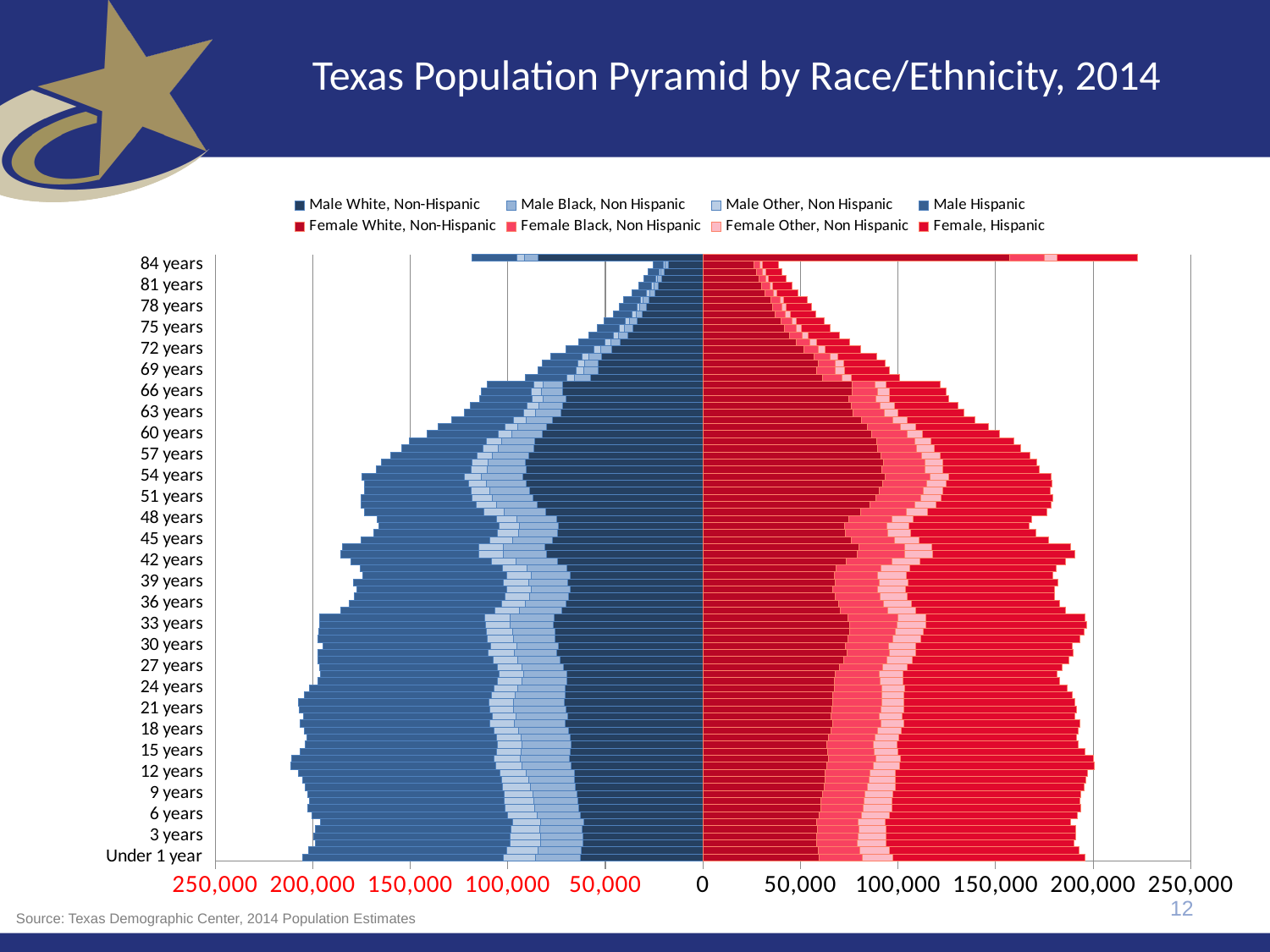
Is the total male value for 78 years greater or less than 50,000? less Do the total male bars rise or fall as age increases from 60 years to 81 years? fall What is the title of the chart? Texas Population Pyramid by Race/Ethnicity, 2014 Is the total male value for 84 years greater or less than 150,000? less What kind of chart is shown on the slide? bar chart How many series does the legend list? 8 On which side of the zero axis are the male series plotted? left Is the total female value for 54 years greater or less than 150,000? greater Which is larger, the total male value for 12 years or the total male value for 72 years? 12 years